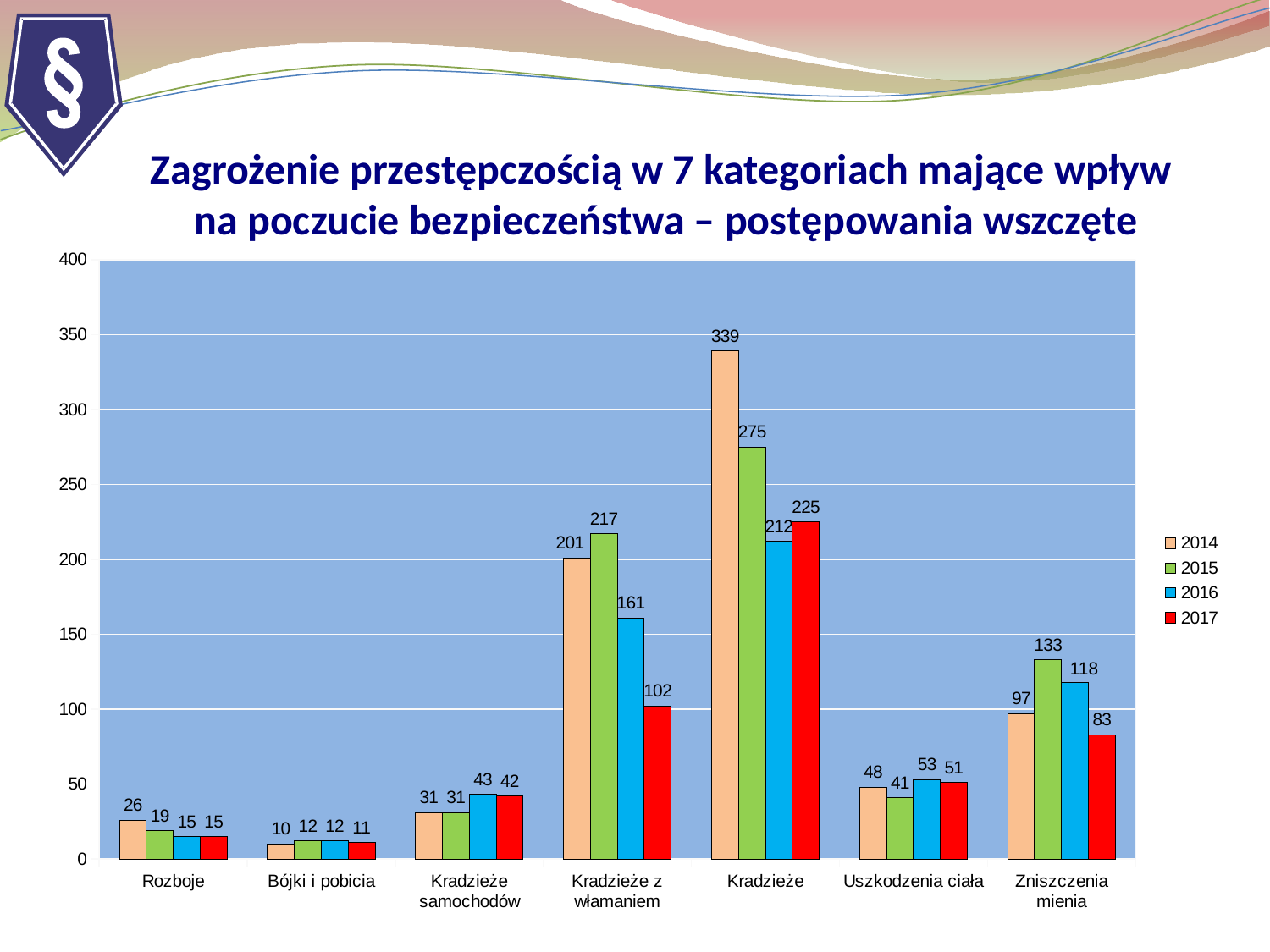
How many series does the legend list? 4 What is the difference between the 2014 and 2017 values for Kradzieże z włamaniem? 99 What is the value for Zniszczenia mienia in 2015? 133 What kind of chart is shown on the slide? bar chart Which category has the lowest value in 2014? Bójki i pobicia What is the value for Kradzieże in 2014? 339 What is the value for Kradzieże z włamaniem in 2017? 102 Which category has the highest value in 2016? Kradzieże Is the value for Kradzieże in 2015 greater or less than 250? greater Which is larger for Uszkodzenia ciała: the 2016 value or the 2015 value? 2016 Do the values for Kradzieże z włamaniem rise or fall from 2015 to 2017? fall How many categories are shown on the x axis? 7